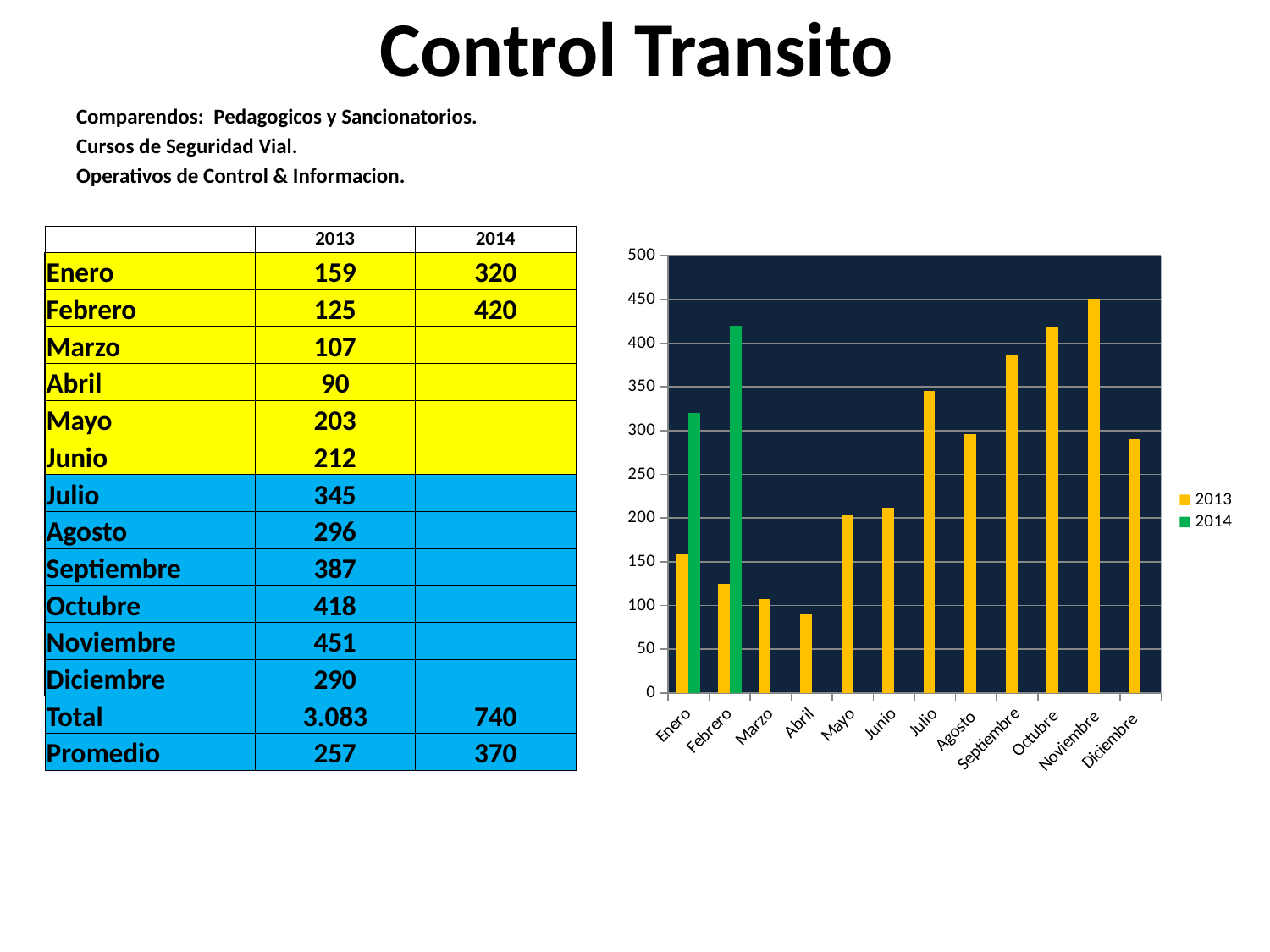
Is the 2013 value for Marzo greater or less than 150? less How many months are shown on the x axis of the chart? 12 How many series does the chart legend list? 2 What is the 2014 value for Febrero? 420 Which month has the highest 2013 value in the chart? Noviembre Which is larger for Enero: the 2013 value or the 2014 value? 2014 What kind of chart is shown on the slide? bar chart What is the difference between the 2014 and 2013 values for Febrero? 295 Which colour represents the 2014 series in the chart? green Which month has the lowest 2013 value in the chart? Abril What is the 2013 value for Noviembre? 451 Is the 2013 value for Julio greater or less than 300? greater